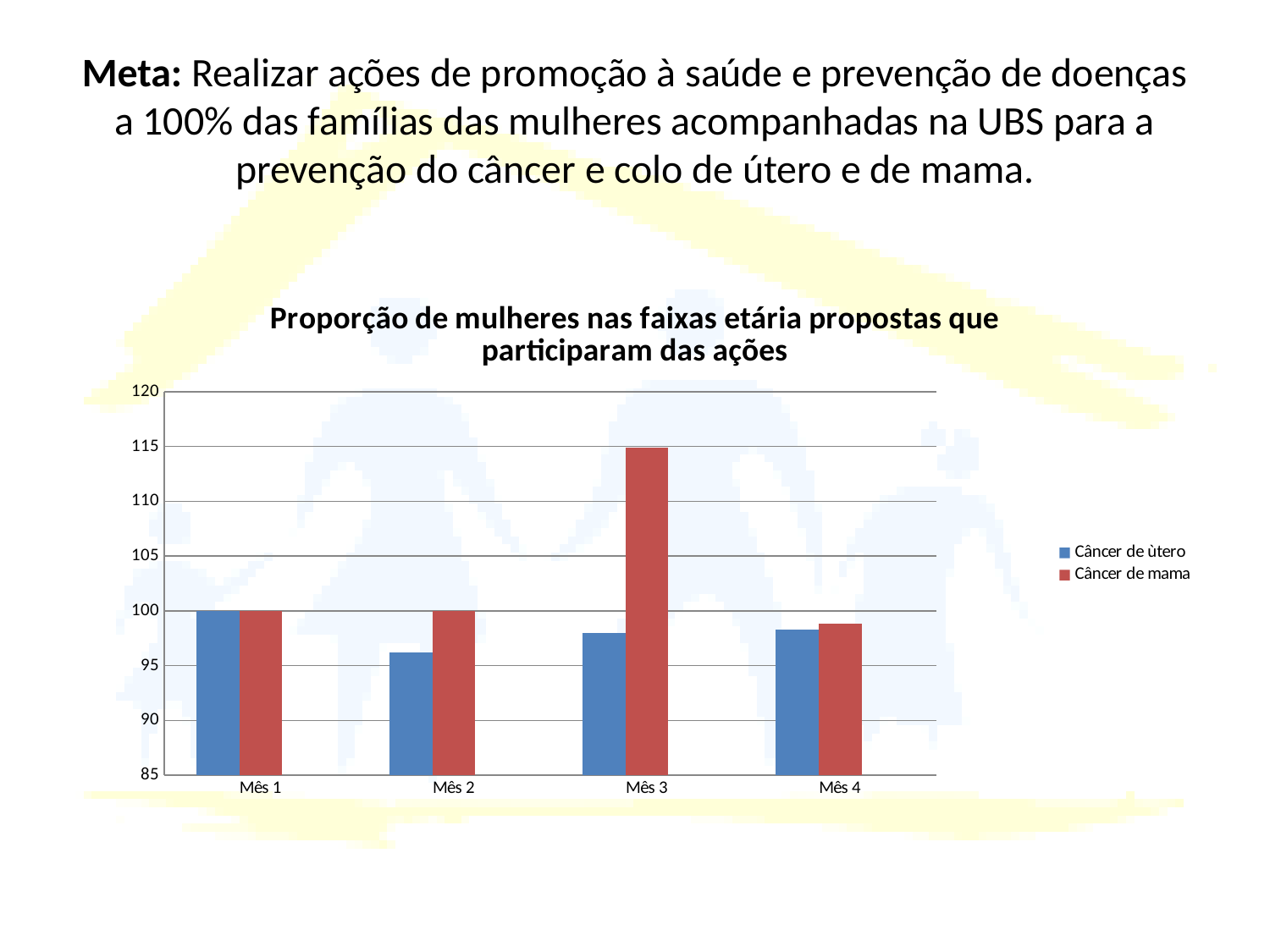
Which series is shown in red? Câncer de mama Is the value for Câncer de ùtero in Mês 2 greater or less than 100? less Is the value for Câncer de ùtero in Mês 3 greater or less than 95? greater Is the value for Câncer de mama in Mês 3 greater or less than 110? greater In Mês 2, which series has the larger value, Câncer de ùtero or Câncer de mama? Câncer de mama How many series does the legend list? 2 In Mês 3, which series has the larger value, Câncer de ùtero or Câncer de mama? Câncer de mama In which month is the value for Câncer de mama highest? Mês 3 How many categories (months) are shown on the x axis? 4 In which month is the value for Câncer de ùtero lowest? Mês 2 What is the title of the chart? Proporção de mulheres nas faixas etária propostas que participaram das ações What kind of chart is shown on the slide? bar chart